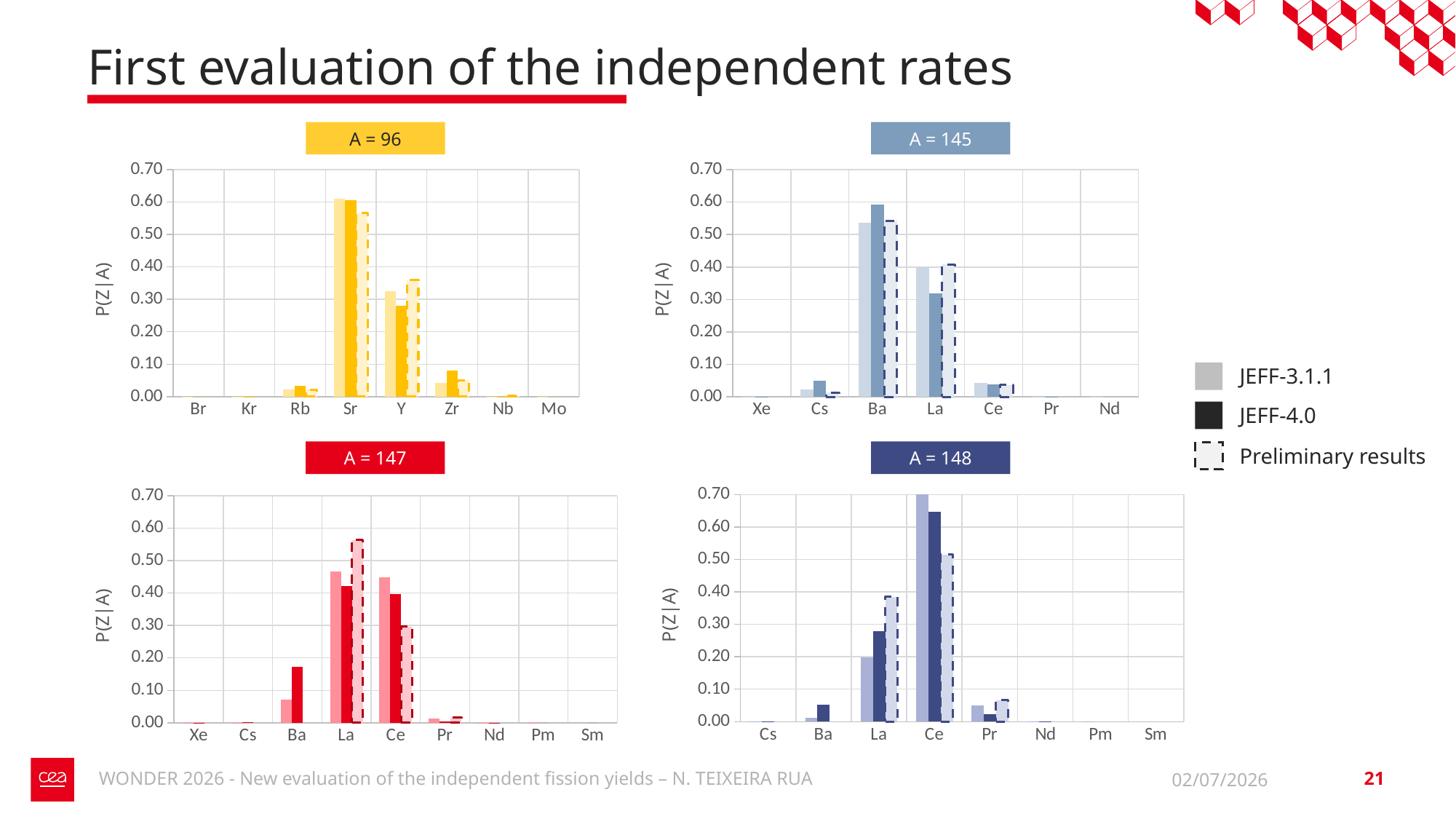
In the A = 145 chart, which is larger for La: the JEFF-3.1.1 value or the JEFF-4.0 value? JEFF-3.1.1 In the A = 145 chart, is the JEFF-4.0 value for Ba greater or less than 0.50? greater What is the label on the y axis of the charts? P(Z|A) In the A = 147 chart, is the JEFF-4.0 value for Ba greater or less than 0.10? greater How many series does the legend list? 3 How many categories are shown on the x axis of the A = 145 chart? 7 What kind of chart is the A = 96 chart? bar chart In the A = 148 chart, which category has the highest values? Ce In the A = 96 chart, which category has the highest values? Sr In the A = 96 chart, is the JEFF-3.1.1 value for Sr greater or less than 0.50? greater In the A = 148 chart, which is larger for La: the JEFF-3.1.1 value or the Preliminary results value? Preliminary results How many categories are shown on the x axis of the A = 147 chart? 9